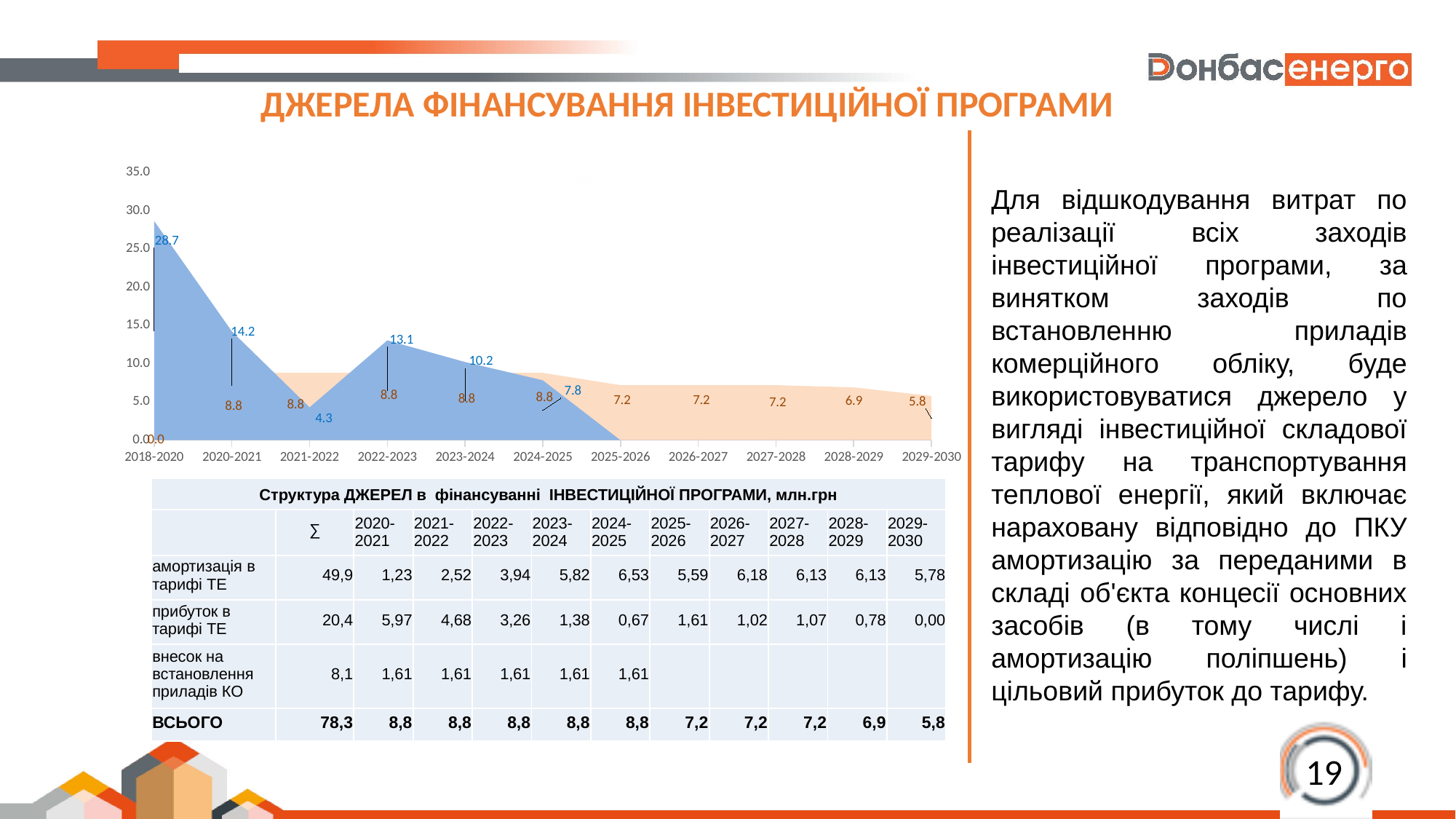
What is the value of the blue series for 2021-2022? 4.3 What is the difference between the blue series values for 2018-2020 and 2020-2021? 14.5 What is the difference between the orange series values for 2024-2025 and 2025-2026? 1.6 Is the value of the blue series for 2023-2024 greater or less than 5.0? greater Does the orange series rise or fall from 2024-2025 to 2029-2030? fall What is the value of the orange series for 2028-2029? 6.9 For 2022-2023, which series has the larger value, the blue or the orange? blue What is the value of the orange series for 2029-2030? 5.8 What is the value of the blue series for 2018-2020? 28.7 What kind of chart is shown on the slide? area chart In which period does the blue series reach its highest value? 2018-2020 How many periods are labelled along the x axis of the chart? 11